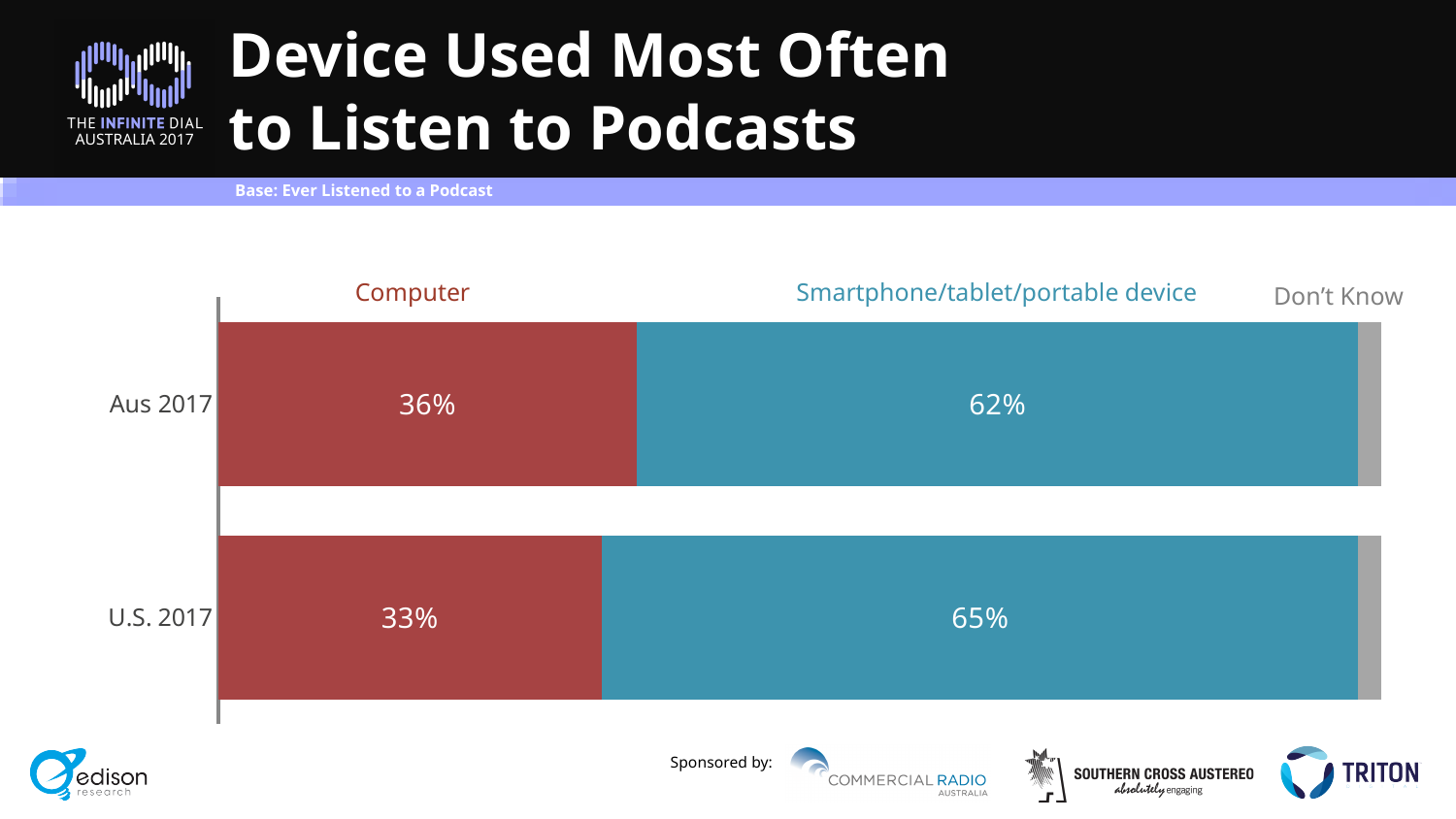
How many series does the chart legend list? 3 Which category has the higher Smartphone/tablet/portable device value, Aus 2017 or U.S. 2017? U.S. 2017 Which category has the higher Computer value, Aus 2017 or U.S. 2017? Aus 2017 What is the value for Smartphone/tablet/portable device for U.S. 2017? 65% What is the difference between the Smartphone/tablet/portable device value and the Computer value for Aus 2017? 26 percentage points Which series is shown in red in the chart? Computer How many categories (bars) are shown in the chart? 2 What is the Computer value for U.S. 2017? 33% What kind of chart is shown on the slide? Stacked bar chart What is the Smartphone/tablet/portable device value for Aus 2017? 62% What percentage of Australian podcast listeners in 2017 use a computer most often to listen to podcasts? 36% By how many percentage points does the Computer value for Aus 2017 exceed that for U.S. 2017? 3 percentage points